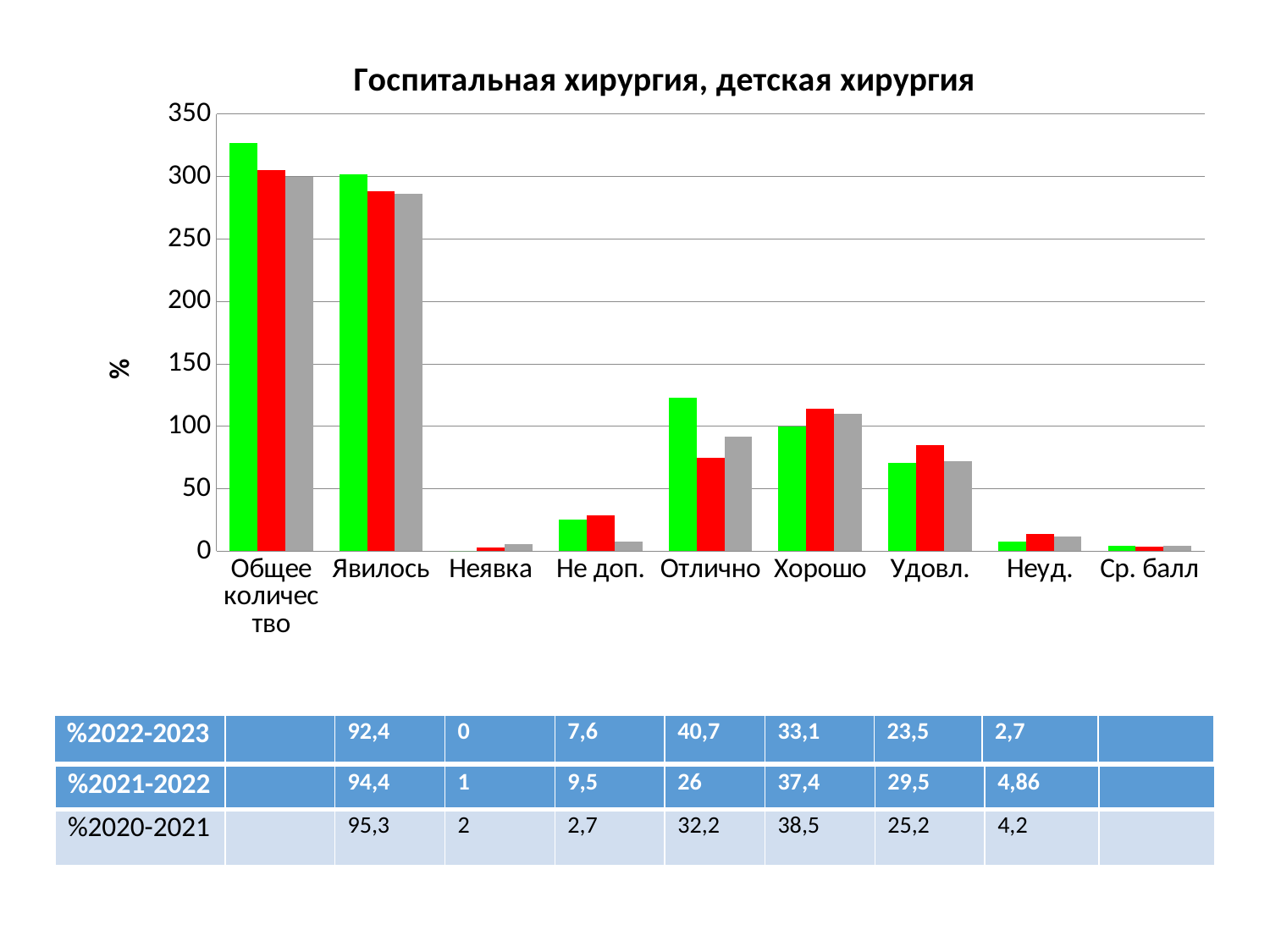
How many categories are shown on the x axis of the chart? 9 Is the green bar for Общее количество greater or less than 300? greater Which category has the tallest bars in the chart? Общее количество Is the green bar for Отлично greater or less than 100? greater Is the red bar for Отлично greater or less than 100? less How many differently coloured bars are plotted for each category in the chart? 3 What type of chart is shown on the slide? bar chart Which red bar is larger: Хорошо or Удовл.? Хорошо What is the title of the chart? Госпитальная хирургия, детская хирургия For the category Отлично, which is larger: the green bar or the red bar? the green bar